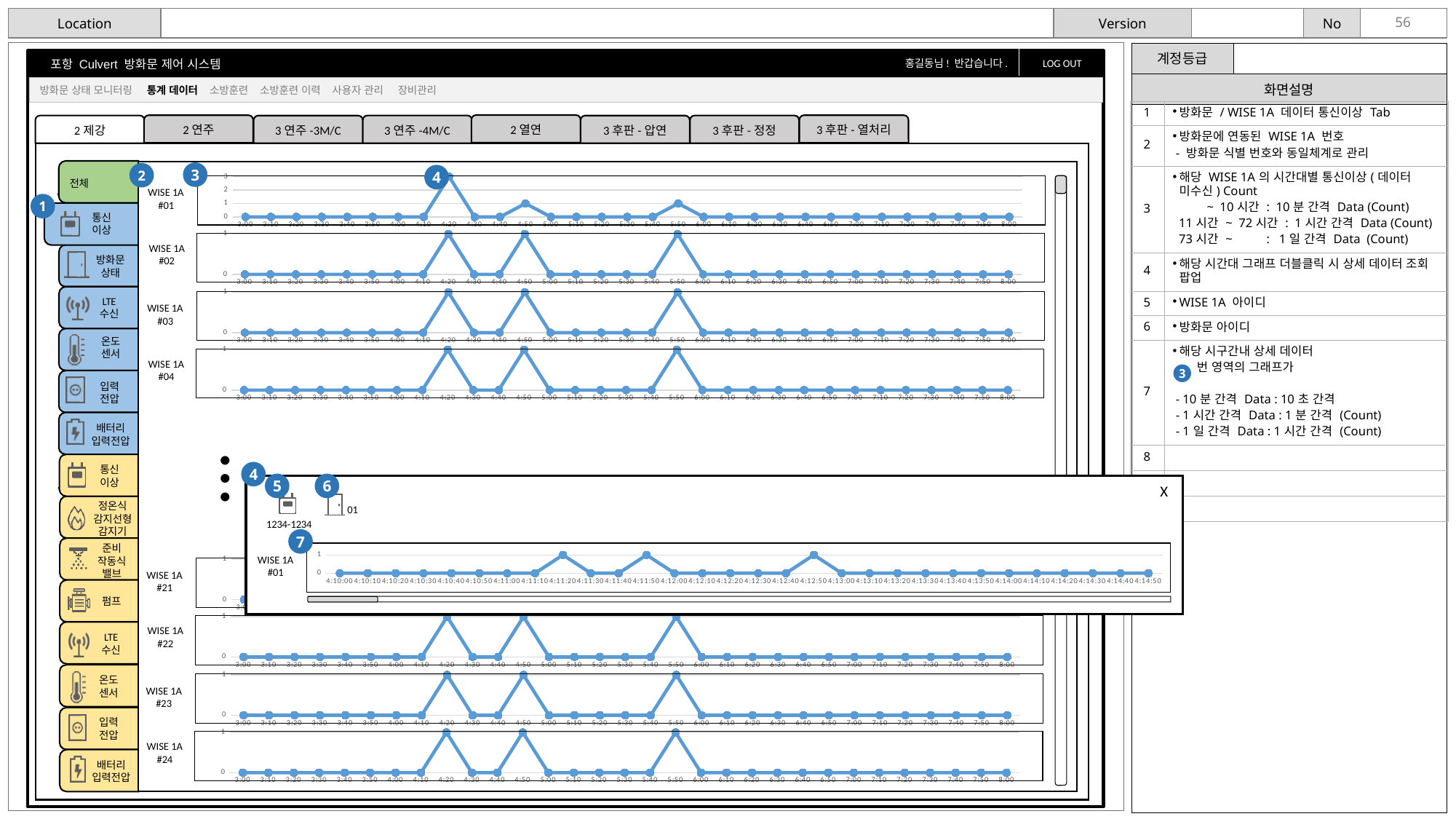
On the WISE 1A #02 chart, what is the value at 4:20? 1 On the WISE 1A #01 chart, which is larger: the value at 4:20 or the value at 4:50? 4:20 On the WISE 1A #02 chart, what is the value at 3:00? 0 On the WISE 1A #01 chart, what is the highest value shown on the y axis? 3 On the WISE 1A #02 chart, how many peaks rise above 0? 3 On the popup WISE 1A #01 chart, what is the first time label on the x axis? 4:10:00 On the WISE 1A #24 chart, what is the value at 8:00? 0 On the WISE 1A #03 chart, at which times does the line rise to 1? 4:20, 4:50, 5:50 What kind of chart is used for the WISE 1A #01 data? line chart On the popup WISE 1A #01 chart, at which times does the value reach 1? 4:11:20, 4:11:50, 4:12:50 On the WISE 1A #01 chart, what is the value at 4:20? 3 On the WISE 1A #01 chart, at which time does the line reach its highest point? 4:20